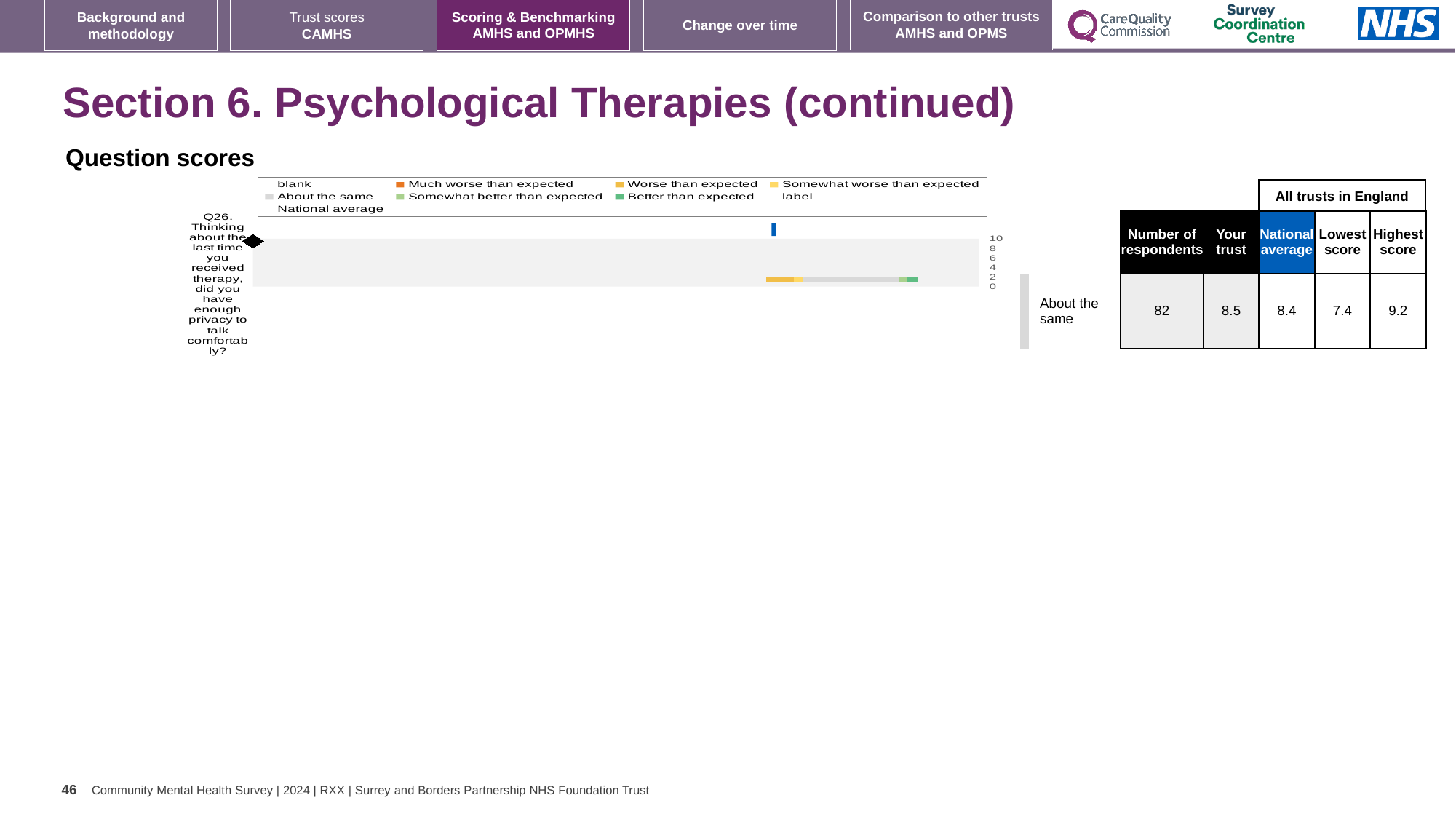
What is the difference between the highest score and the lowest score for Q26 in the table? 1.8 In the table next to the chart, what is the 'Your trust' score for Q26? 8.5 How many questions (categories) are plotted in the chart? 1 How many respondents answered Q26 according to the table next to the chart? 82 Which question is plotted in the chart? Q26. Thinking about the last time you received therapy, did you have enough privacy to talk comfortably? What benchmark category label is shown beside the chart for Q26? About the same What kind of chart is shown under 'Question scores'? bar chart What is the highest tick value shown on the chart's axis? 10 In the table next to the chart, what is the highest score among all trusts in England for Q26? 9.2 Which is larger for Q26, the 'Your trust' score or the national average? Your trust In the table next to the chart, what is the national average for Q26? 8.4 In the table next to the chart, what is the lowest score among all trusts in England for Q26? 7.4